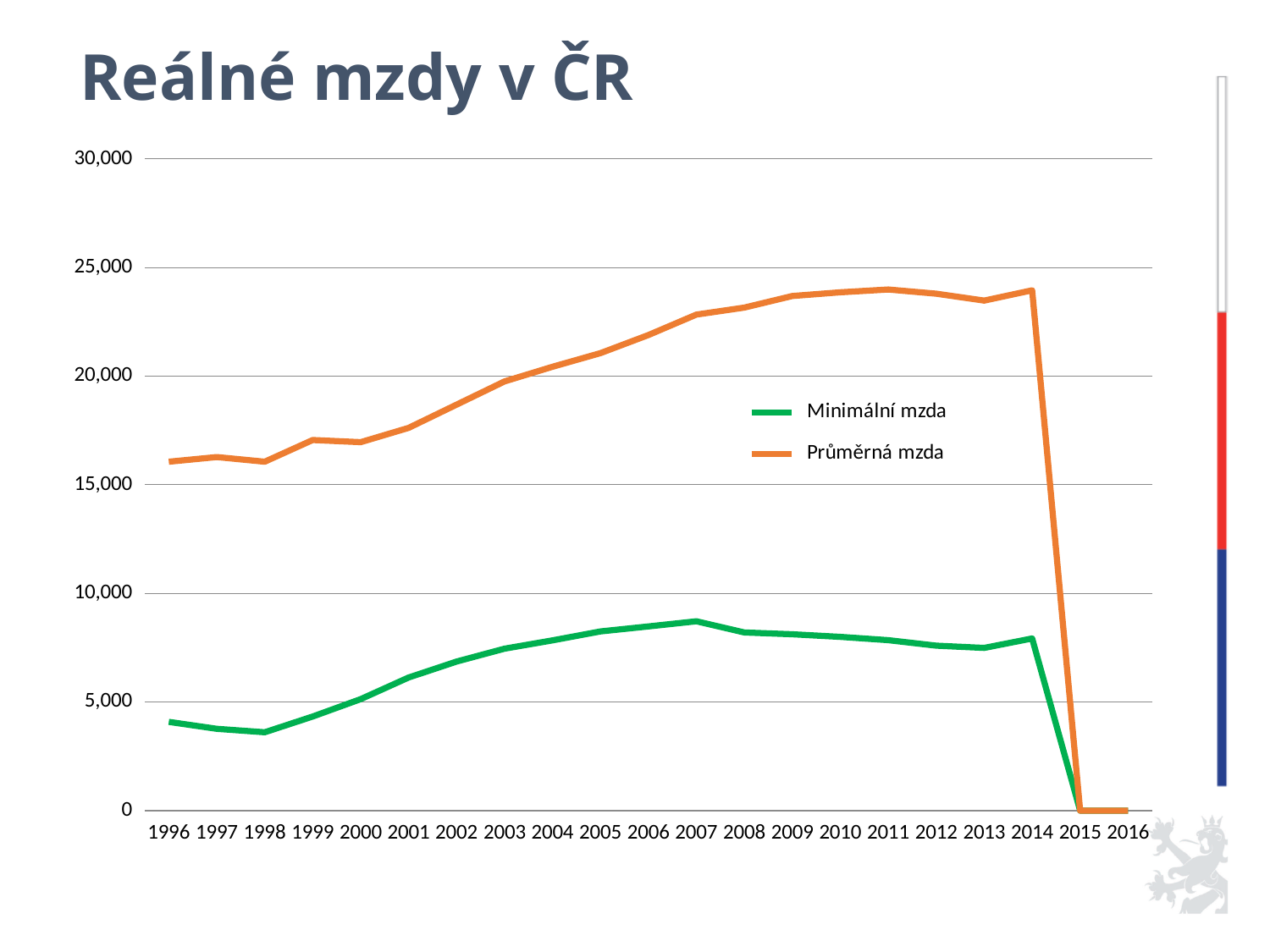
What is the value of Průměrná mzda in 2016? 0 How many series does the legend list? 2 In 2010, which series has the higher value, Minimální mzda or Průměrná mzda? Průměrná mzda Is the value of Průměrná mzda in 1996 greater or less than 15,000? greater How many years are shown on the x axis? 21 Is the value of Průměrná mzda in 2011 greater or less than 20,000? greater Does Průměrná mzda rise or fall from 1996 to 2011? rise Is the value of Minimální mzda in 2007 greater or less than 10,000? less What kind of chart is shown on the slide? line chart Which year has the highest value of Minimální mzda? 2007 What is the value of Minimální mzda in 2015? 0